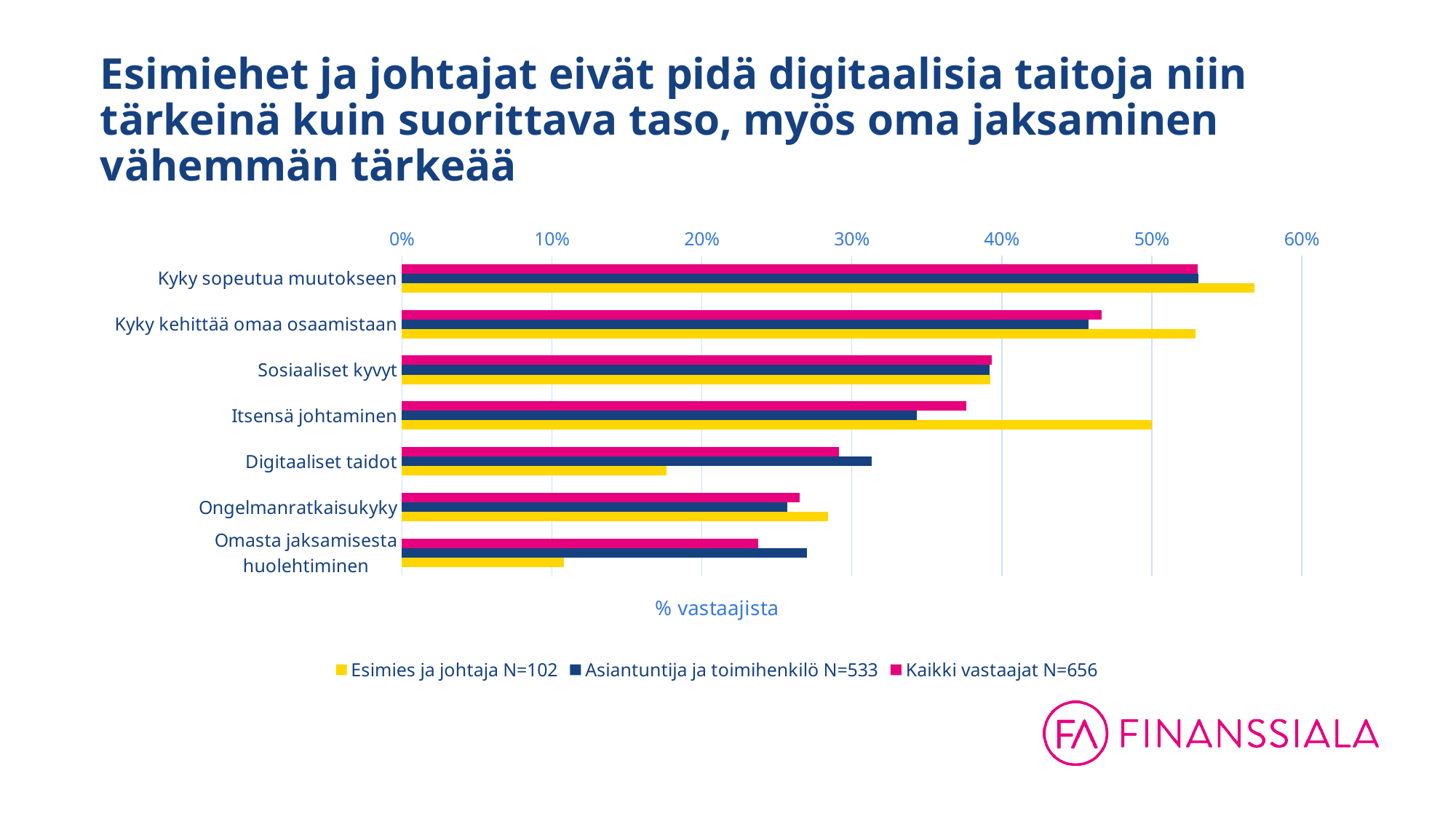
What kind of chart is shown on the slide? bar chart Which category has the highest value for the series 'Kaikki vastaajat N=656'? Kyky sopeutua muutokseen Which category has the lowest value for the series 'Esimies ja johtaja N=102'? Omasta jaksamisesta huolehtiminen For 'Itsensä johtaminen', which series has the larger value: 'Esimies ja johtaja N=102' or 'Kaikki vastaajat N=656'? Esimies ja johtaja N=102 For 'Digitaaliset taidot', which series has the larger value: 'Esimies ja johtaja N=102' or 'Asiantuntija ja toimihenkilö N=533'? Asiantuntija ja toimihenkilö N=533 Which category has the highest value for the series 'Esimies ja johtaja N=102'? Kyky sopeutua muutokseen Is the value for 'Digitaaliset taidot' in the series 'Esimies ja johtaja N=102' greater or less than 20%? less How many categories (skills) are listed on the vertical axis of the chart? 7 How many series does the chart's legend list? 3 What is the title of the horizontal axis of the chart? % vastaajista Is the value for 'Kyky sopeutua muutokseen' in the series 'Kaikki vastaajat N=656' greater or less than 50%? greater Is the value for 'Itsensä johtaminen' in the series 'Esimies ja johtaja N=102' greater or less than 40%? greater